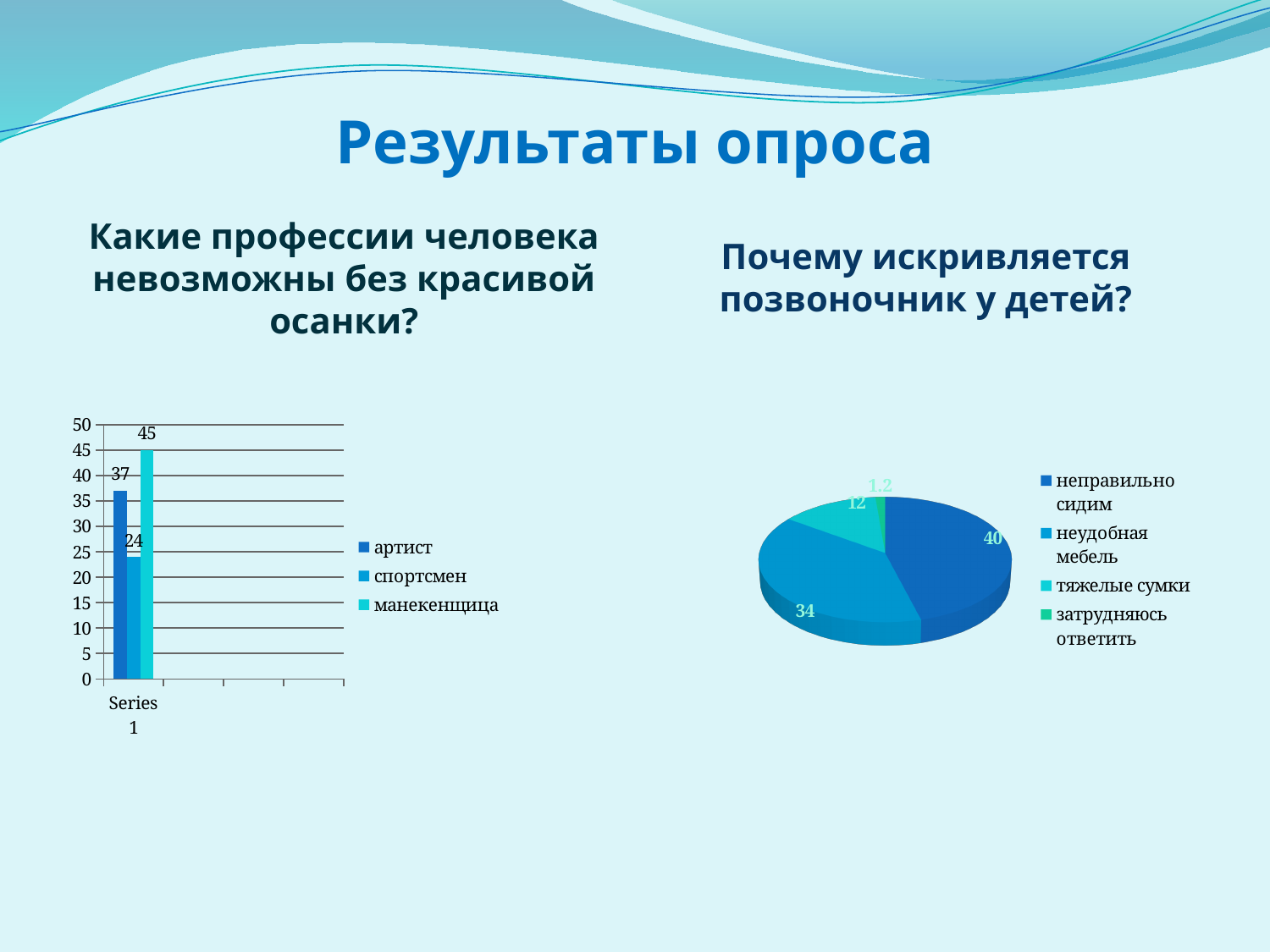
On the right pie chart, what is the value for неудобная мебель? 34 On the left bar chart, what is the difference between the values for манекенщица and спортсмен? 21 What kind of chart is shown on the left side of the slide? Bar chart On the right pie chart, which is larger: тяжелые сумки or неудобная мебель? неудобная мебель On the right pie chart, what is the value for затрудняюсь ответить? 1.2 On the left bar chart, what is the value for манекенщица? 45 On the left bar chart, which series has the lowest value? спортсмен How many series does the legend of the left bar chart list? 3 On the left bar chart, which series has the highest value? манекенщица How many categories does the legend of the right pie chart list? 4 On the right pie chart, which category has the largest slice? неправильно сидим On the left bar chart, what is the value for артист? 37